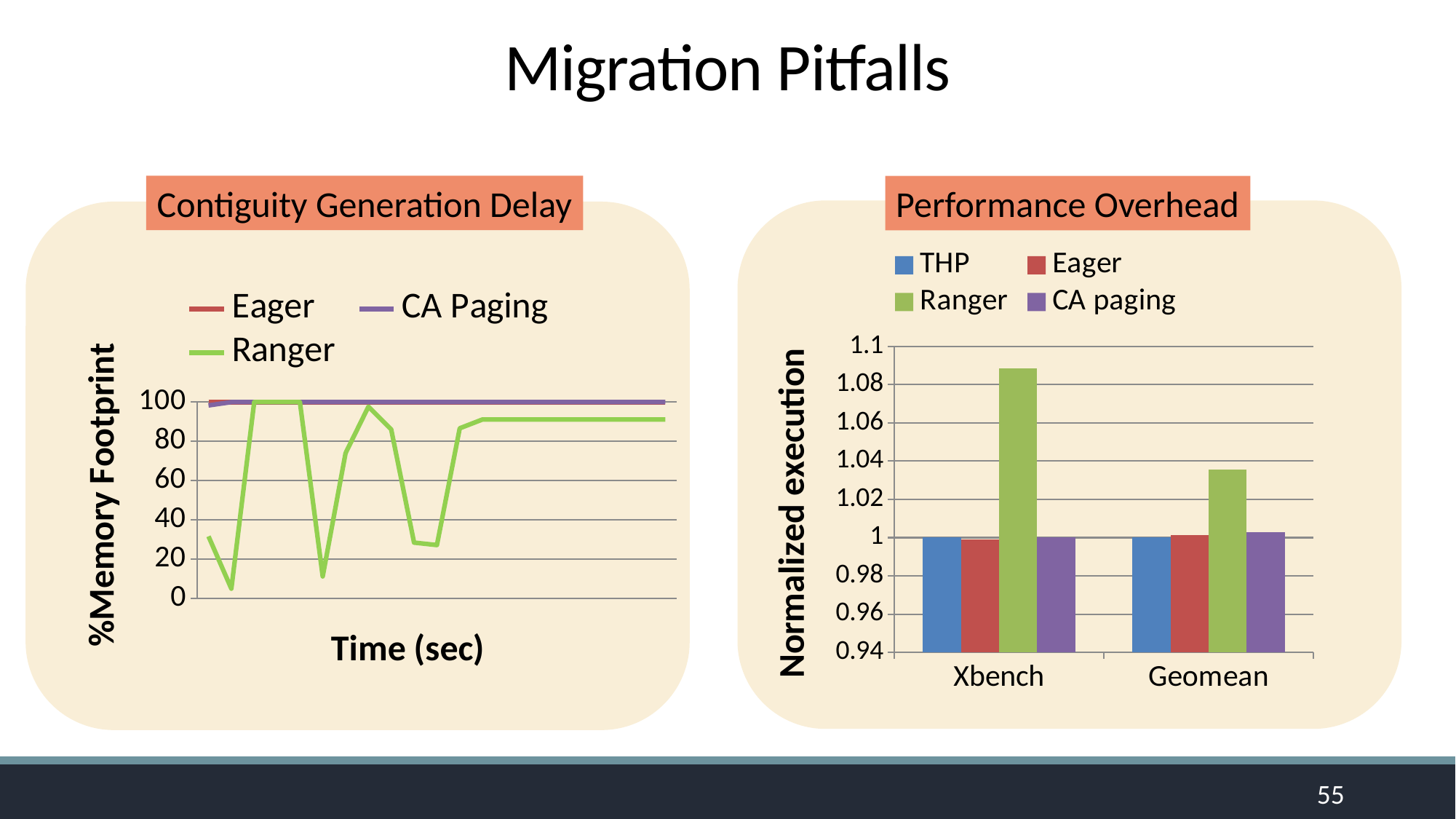
What kind of chart is the Contiguity Generation Delay chart? line chart How many series does the legend of the Performance Overhead chart list? 4 In the Contiguity Generation Delay chart, is the lowest point of the Ranger line greater or less than 20? less What kind of chart is the Performance Overhead chart? bar chart How many categories are shown on the x axis of the Performance Overhead chart? 2 In the Performance Overhead chart, is the Ranger value for Geomean greater or less than 1.04? less How many series does the legend of the Contiguity Generation Delay chart list? 3 In the Performance Overhead chart, what is the THP value for Xbench? 1 In the Performance Overhead chart, is the Ranger value larger for Xbench or for Geomean? Xbench In the Performance Overhead chart, which series has the highest value for Xbench? Ranger What is the y-axis label of the Contiguity Generation Delay chart? %Memory Footprint In the Performance Overhead chart, is the Ranger value for Xbench greater or less than 1.08? greater